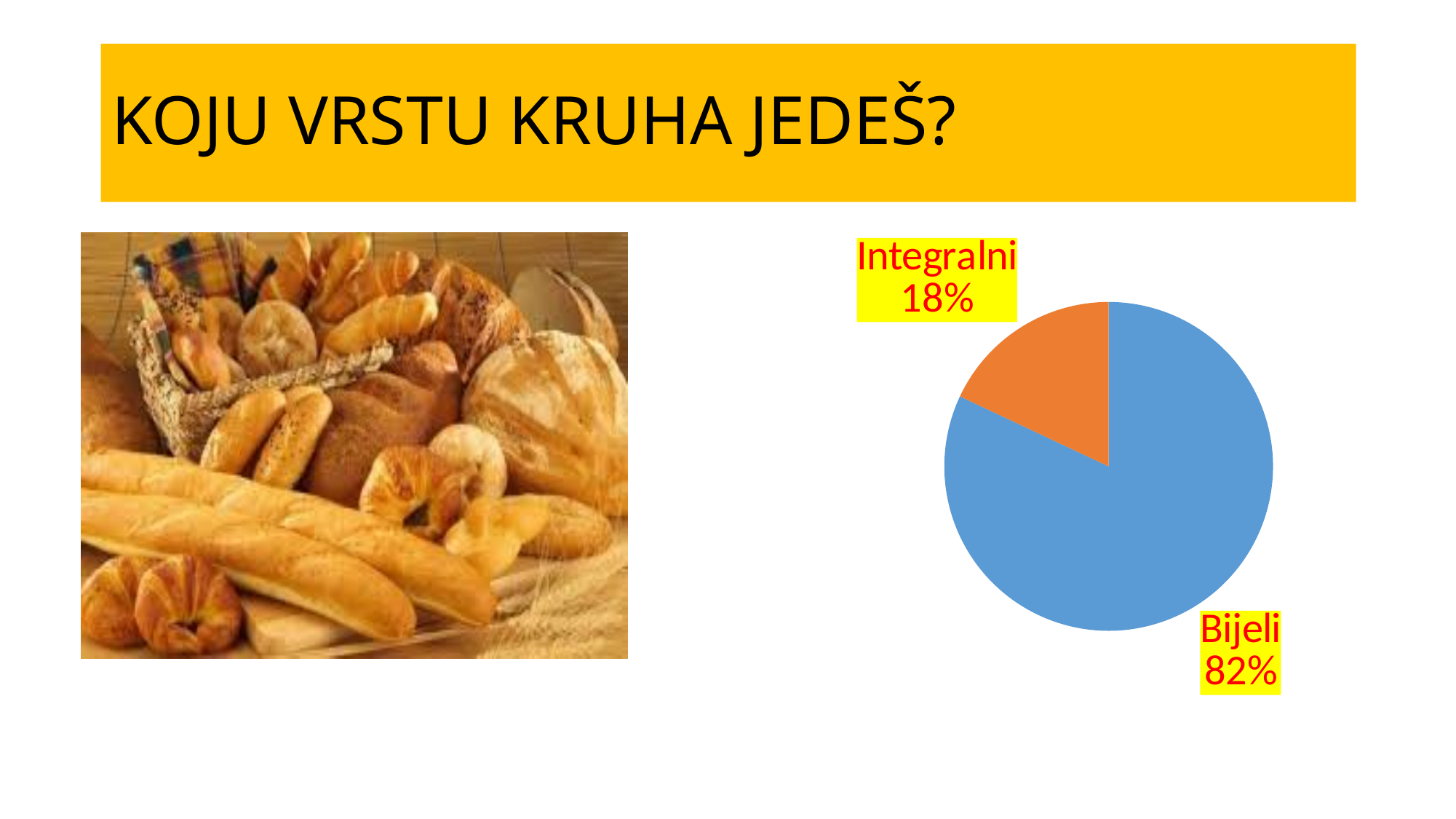
Which is larger, the Bijeli slice or the Integralni slice? Bijeli Which slice of the pie chart is the smallest? Integralni What colour is the Bijeli slice of the pie chart? blue What share of the pie does the Integralni slice represent? 18% What is the difference in percentage points between the Bijeli and Integralni slices? 64 What percentage of the pie chart is labelled Integralni? 18% What percentage of the pie chart is labelled Bijeli? 82% How many slices does the pie chart have? 2 What kind of chart is shown on the slide? pie chart What colour is the Integralni slice of the pie chart? orange Which slice of the pie chart is the largest? Bijeli